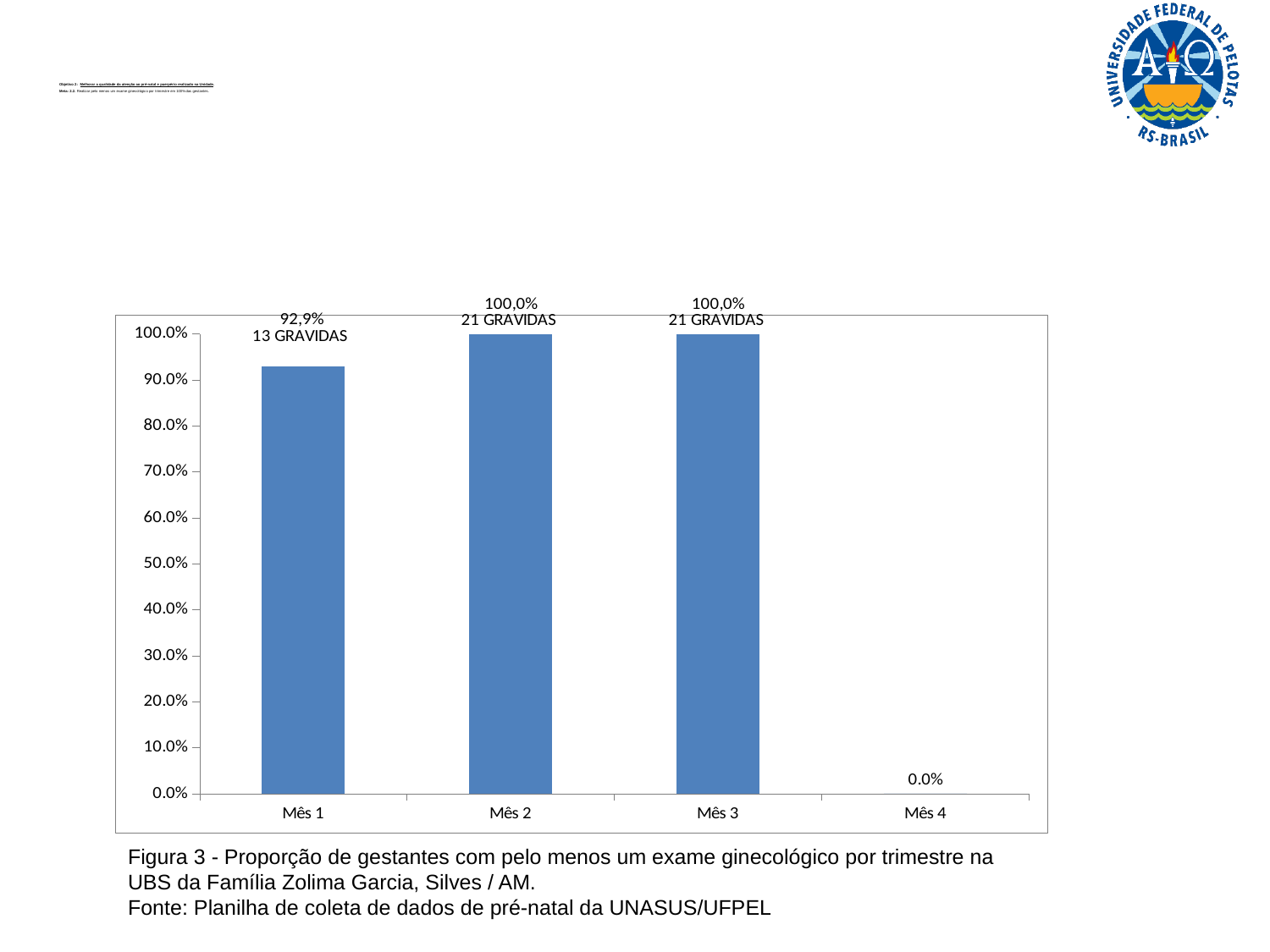
Which is larger, the value for Mês 1 or the value for Mês 3? Mês 3 What kind of chart is shown on the slide? Bar chart Is the value for Mês 1 greater or less than 90.0%? greater How many pregnant women (GRAVIDAS) are indicated in the label for Mês 1? 13 GRAVIDAS Which category has the lowest value? Mês 4 What is the value for Mês 1? 92,9% How many pregnant women (GRAVIDAS) are indicated in the label for Mês 3? 21 GRAVIDAS How many categories are shown on the x axis? 4 What is the figure number given in the caption below the chart? Figura 3 What is the difference between the values for Mês 2 and Mês 1? 7,1% What is the value for Mês 4? 0.0% What is the value for Mês 2? 100,0%